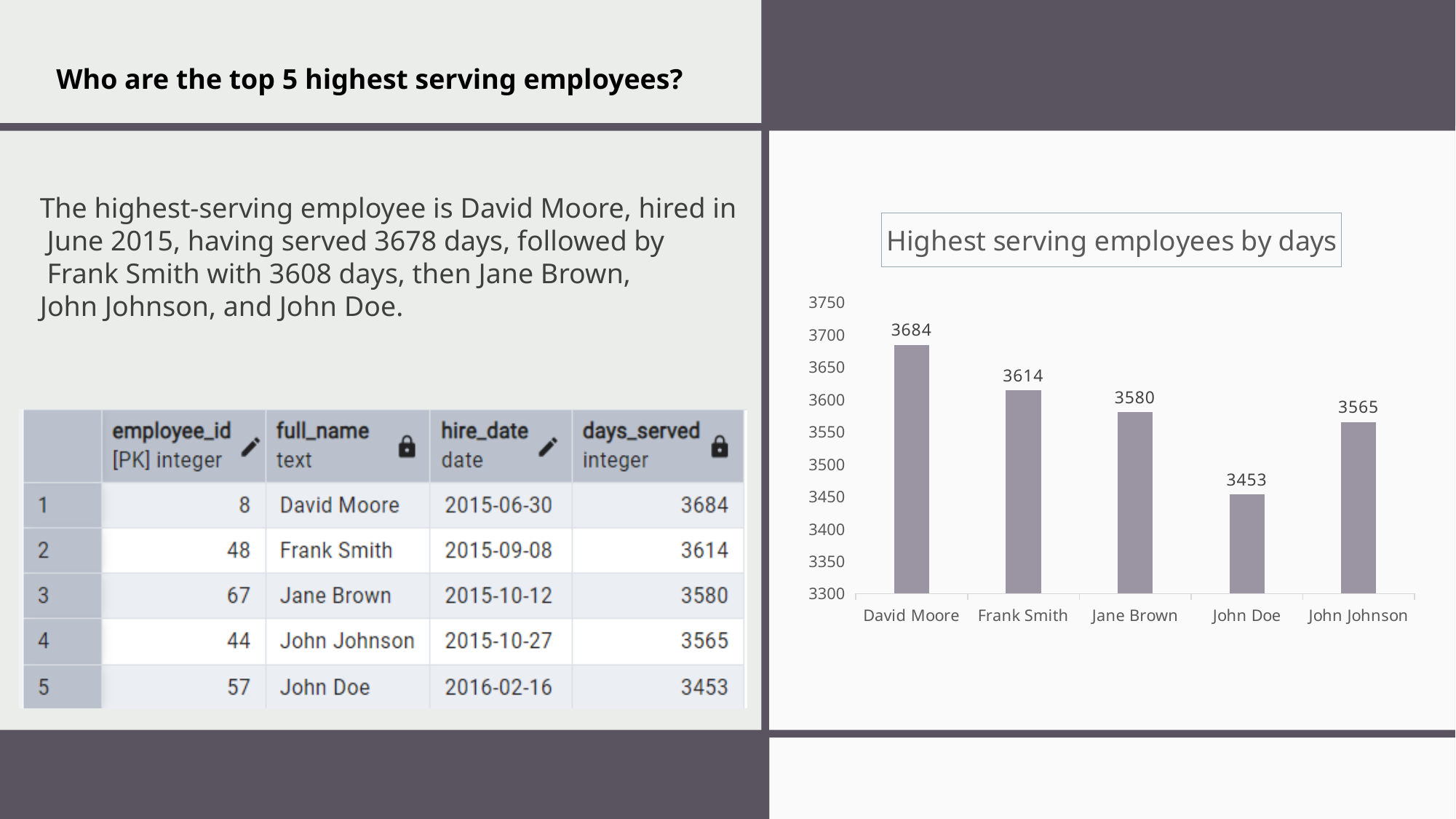
What is the title of the chart? Highest serving employees by days What is the value for David Moore in the chart? 3684 Is the value for John Doe greater or less than 3500? less What kind of chart is shown on the slide? bar chart What is the value for Jane Brown in the chart? 3580 What is the value for John Doe in the chart? 3453 What is the difference between the values for John Johnson and John Doe? 112 How many employees are shown in the chart? 5 Which employee has the highest value in the chart? David Moore What is the difference between the values for David Moore and Frank Smith? 70 Which is larger, the value for Jane Brown or the value for John Johnson? Jane Brown Which employee has the lowest value in the chart? John Doe